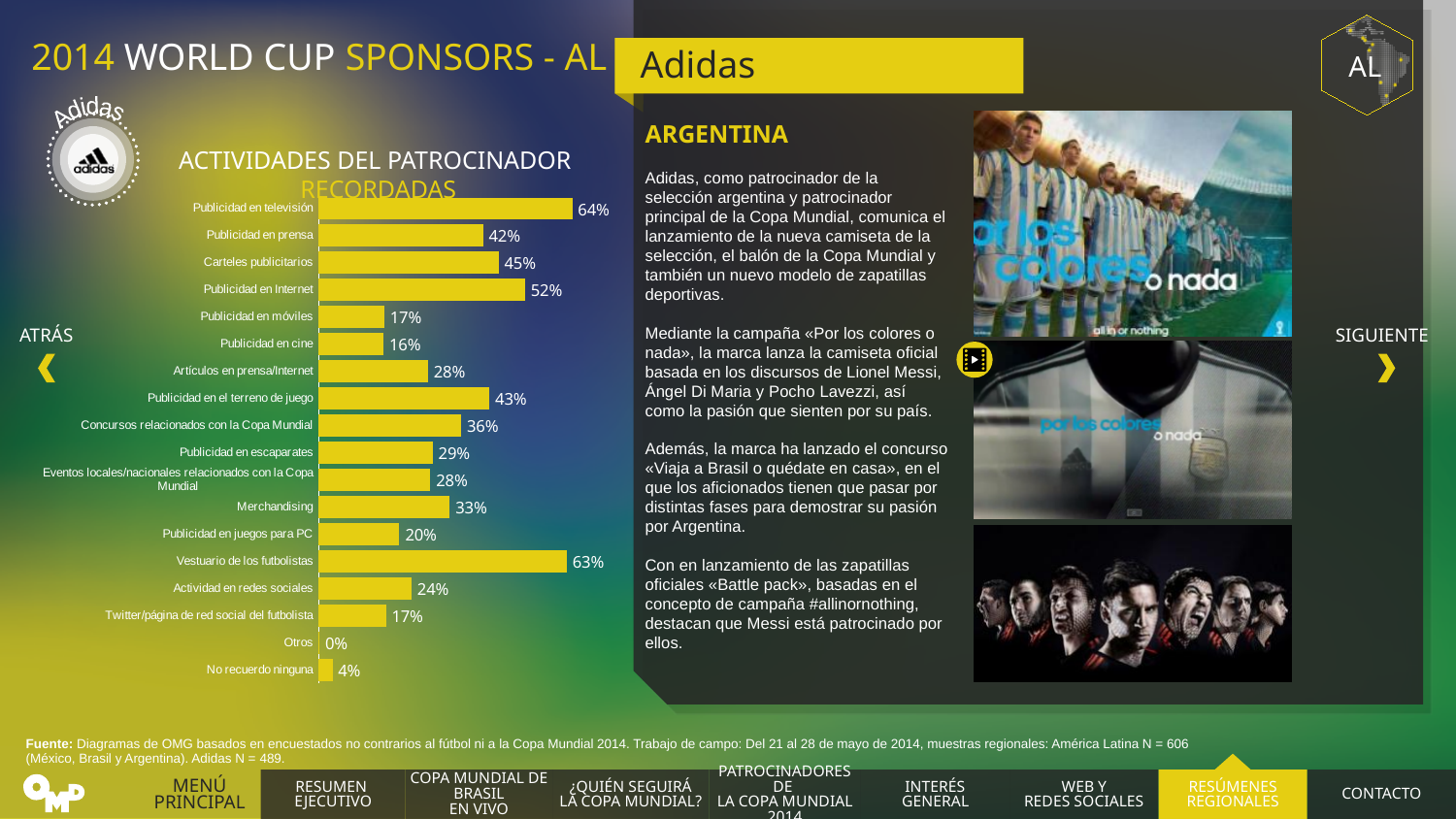
Which category has the highest value? Publicidad en televisión What is the title of the chart? ACTIVIDADES DEL PATROCINADOR RECORDADAS How many categories are shown in the chart? 18 What is the difference between Merchandising and Actividad en redes sociales? 9% What is the value for Publicidad en Internet? 52% What is the difference between Publicidad en Internet and Publicidad en prensa? 10% What is the value for Publicidad en televisión? 64% Which category has the lowest value? Otros What is the value for Vestuario de los futbolistas? 63% Which is larger, Carteles publicitarios or Publicidad en el terreno de juego? Carteles publicitarios What is the value for No recuerdo ninguna? 4% What kind of chart is shown on the slide? Bar chart